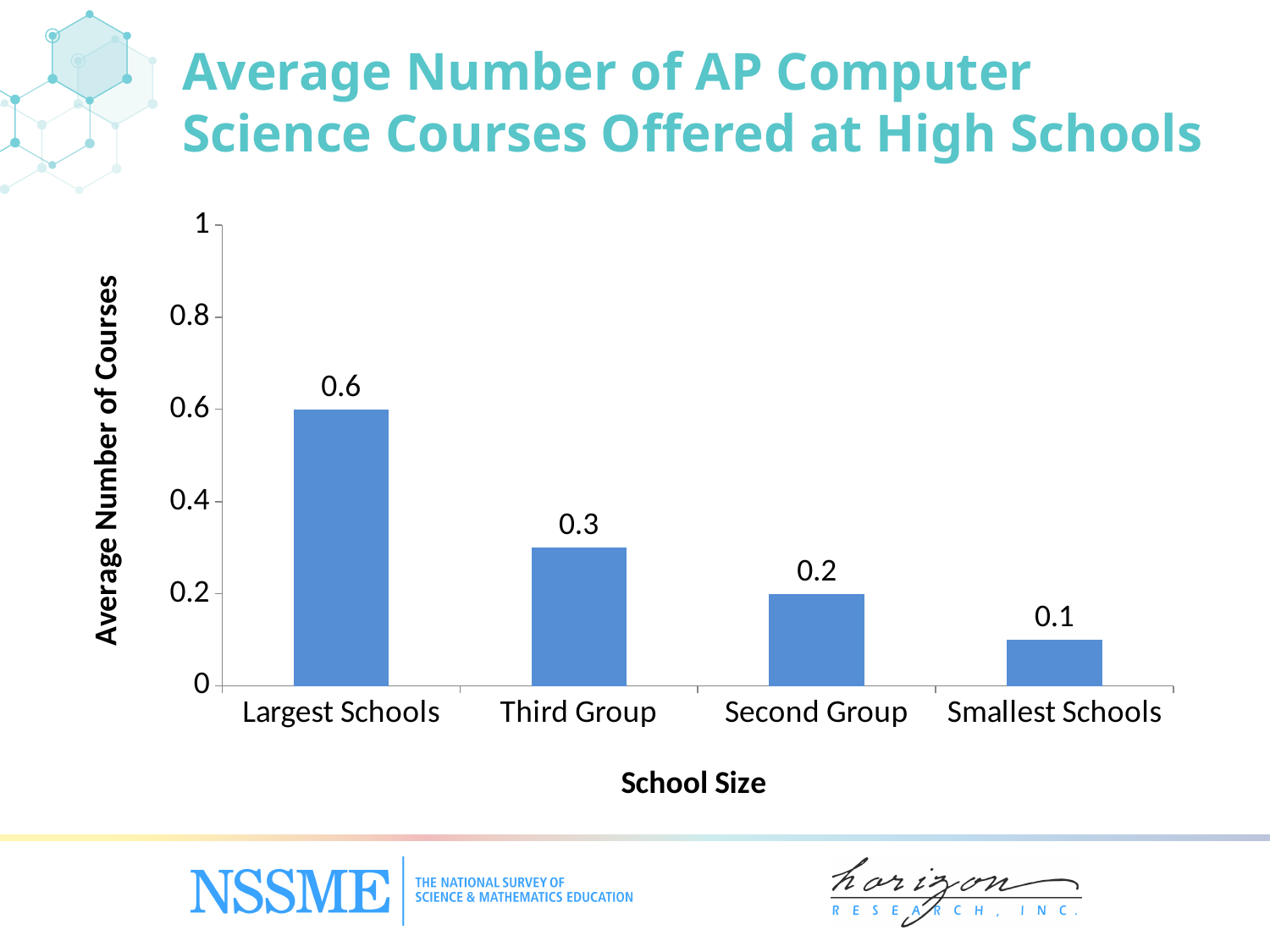
What is the value shown for the Third Group? 0.3 What is the average number of AP Computer Science courses offered at the Largest Schools? 0.6 Which school size group has the highest average number of courses? Largest Schools What is the difference between the values for the Largest Schools and the Smallest Schools? 0.5 Do the values rise or fall moving from left to right along the x axis? Fall Which is larger, the value for the Third Group or the value for the Second Group? Third Group What kind of chart is shown on the slide? Bar chart How many school size categories are shown on the chart? 4 What is the value shown for the Smallest Schools? 0.1 Is the value for the Largest Schools greater or less than 0.4? greater Which school size group has the lowest average number of courses? Smallest Schools What is the value shown for the Second Group? 0.2